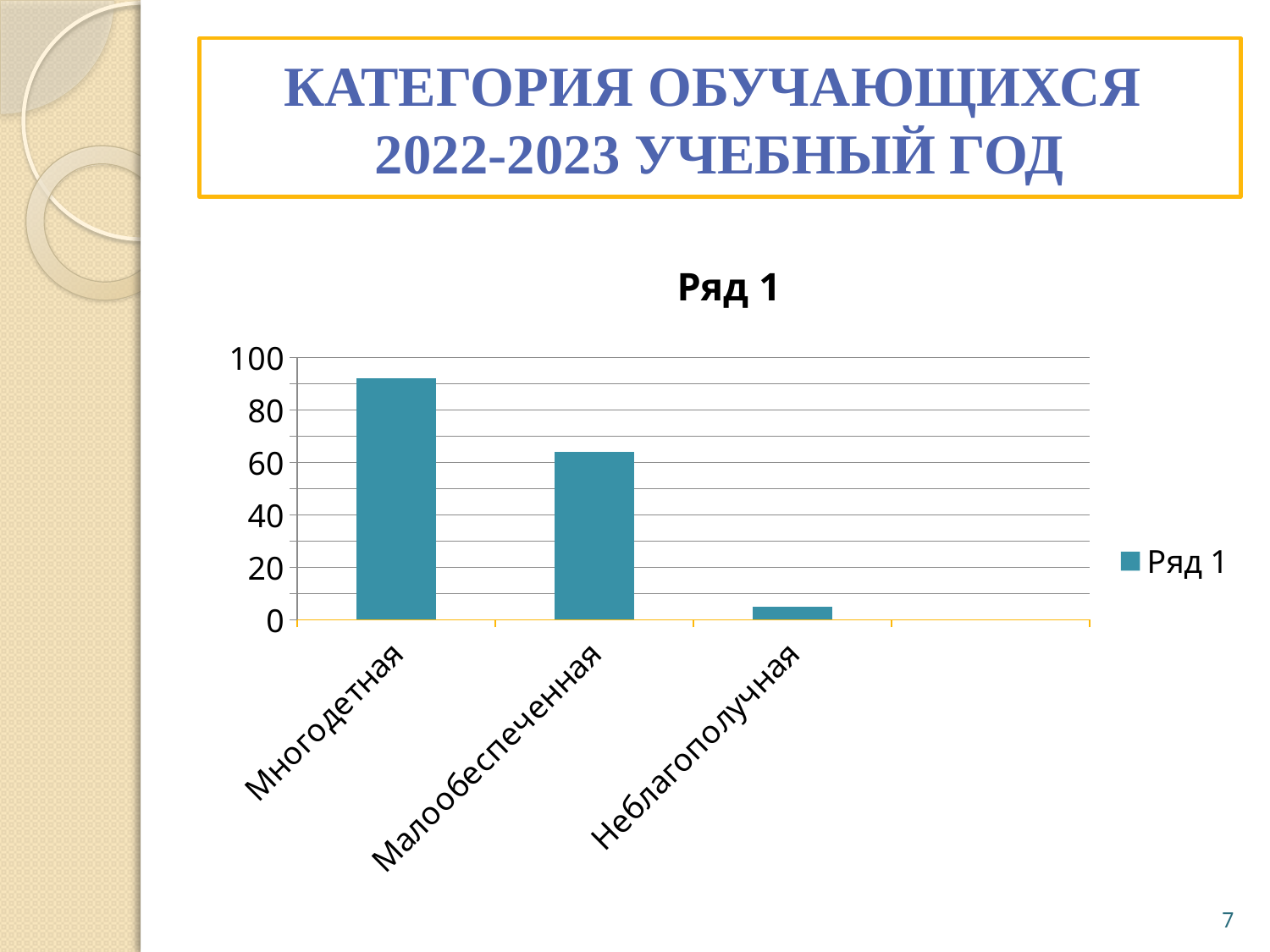
Which category has the highest bar in the chart? Многодетная Is the value for Многодетная greater or less than 80? greater Do the bar values rise or fall from left to right along the x axis? fall How many series does the chart legend list? 1 Is the value for Неблагополучная greater or less than 20? less Which category has the lowest bar in the chart? Неблагополучная Is the value for Малообеспеченная greater or less than 80? less Which is larger, the value for Малообеспеченная or the value for Неблагополучная? Малообеспеченная What kind of chart is shown on the slide? bar chart What is the title shown above the chart? Ряд 1 Which is larger, the value for Многодетная or the value for Малообеспеченная? Многодетная How many categories are plotted on the x axis of the chart? 3